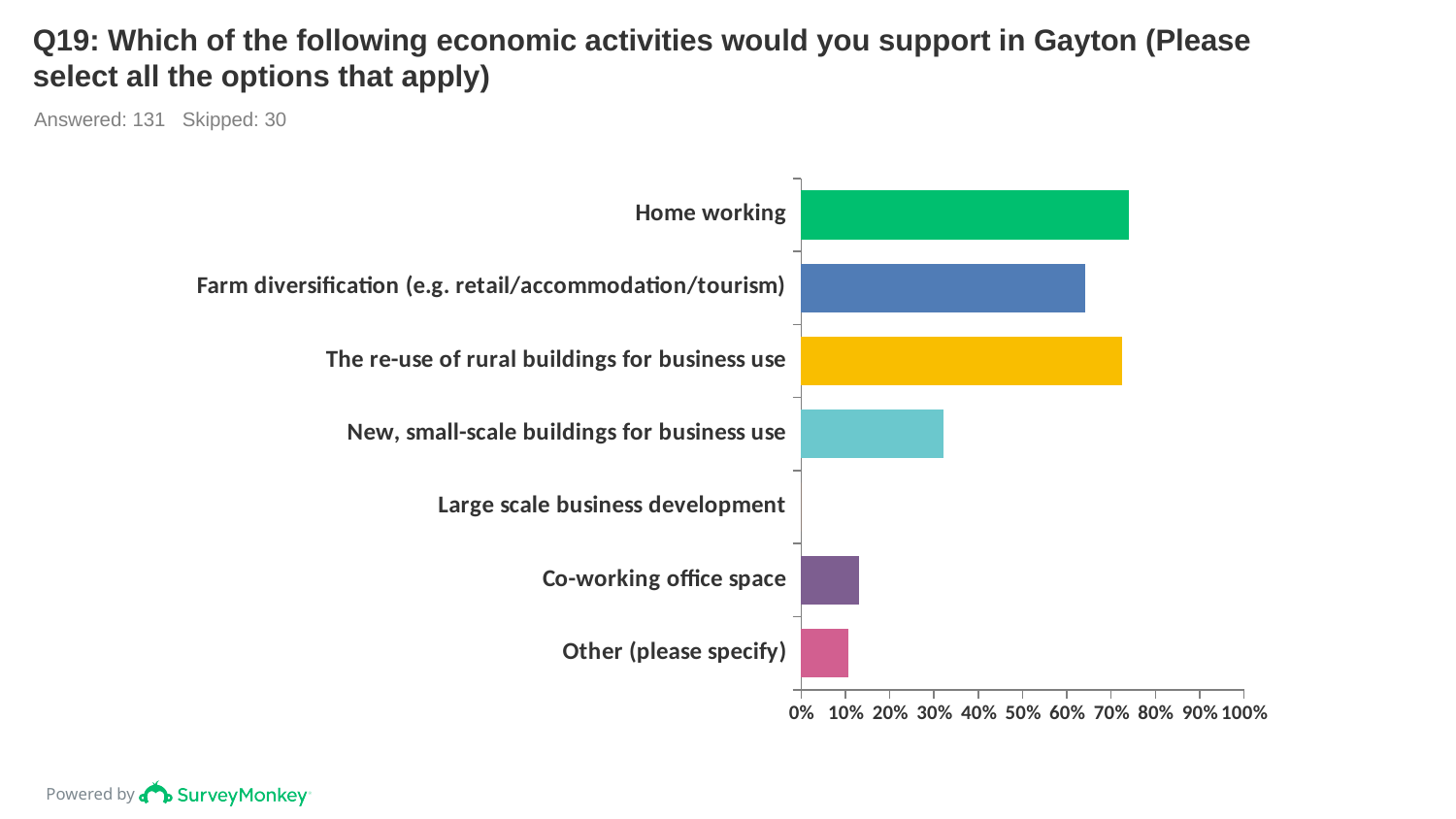
What is the maximum value shown on the percentage axis of the chart? 100% What kind of chart is shown on the slide? Bar chart How many economic activity categories are plotted in the chart? 7 How many respondents answered this question according to the slide? 131 Is the value for Co-working office space greater or less than 20%? less Which has a larger value: Home working or New, small-scale buildings for business use? Home working Is the value for Farm diversification (e.g. retail/accommodation/tourism) greater or less than 60%? greater Is the value for Home working greater or less than 70%? greater Which has a larger value: The re-use of rural buildings for business use or Farm diversification (e.g. retail/accommodation/tourism)? The re-use of rural buildings for business use Which category has the lowest value in the chart? Large scale business development